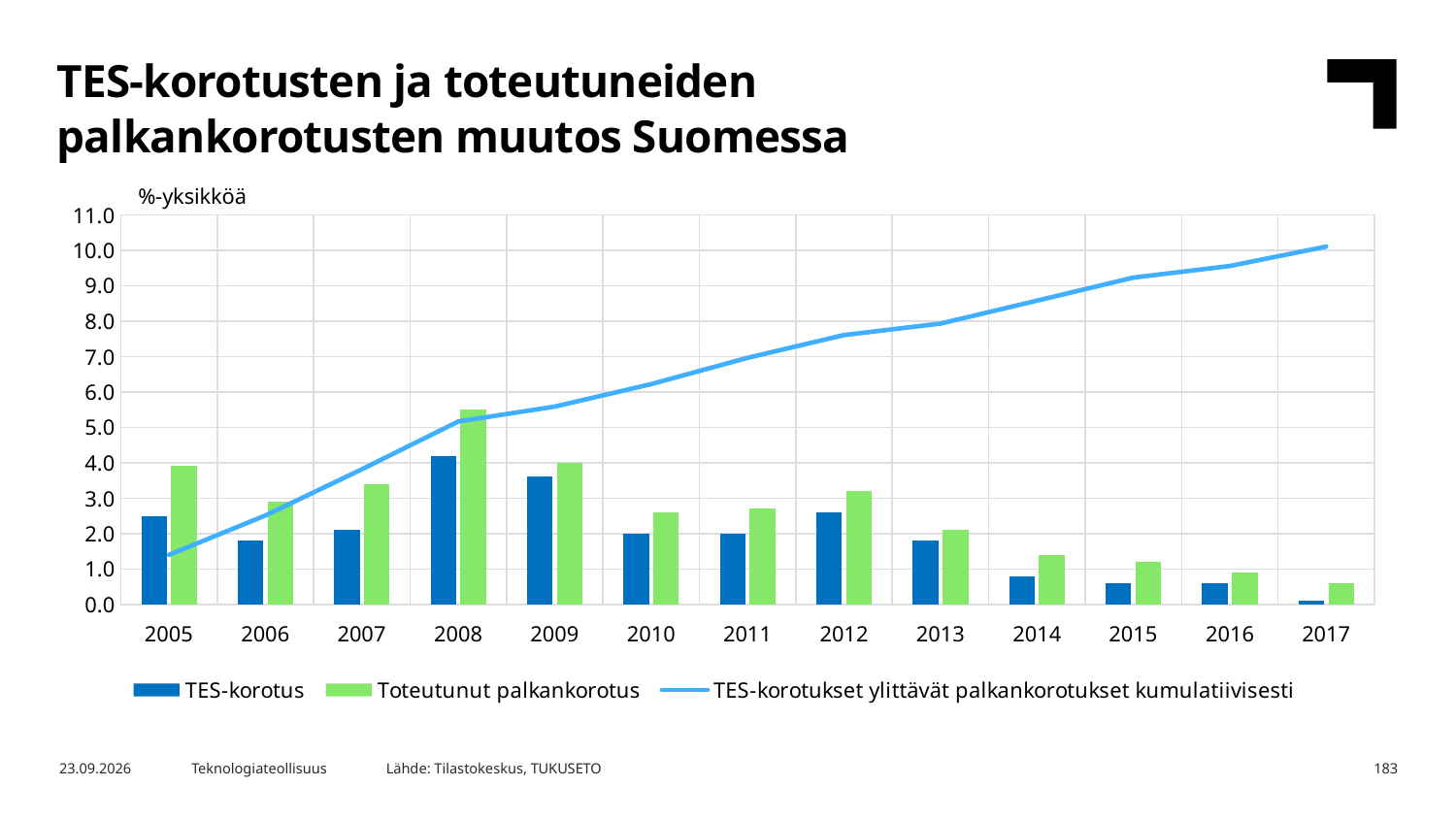
In which year is the TES-korotus bar the lowest? 2017 How many series does the chart legend list? 3 In which year is the TES-korotus bar the highest? 2008 Is the Toteutunut palkankorotus value for 2008 greater or less than 5.0? greater What kind of chart is shown on the slide? A bar chart combined with a line chart Does the line 'TES-korotukset ylittävät palkankorotukset kumulatiivisesti' rise or fall from 2005 to 2017? It rises Which is larger in 2005, the TES-korotus bar or the Toteutunut palkankorotus bar? Toteutunut palkankorotus In which year is the Toteutunut palkankorotus bar the highest? 2008 How many years are shown on the x axis of the chart? 13 Is the TES-korotus value for 2014 greater or less than 1.0? less What unit label is shown above the vertical axis of the chart? %-yksikköä